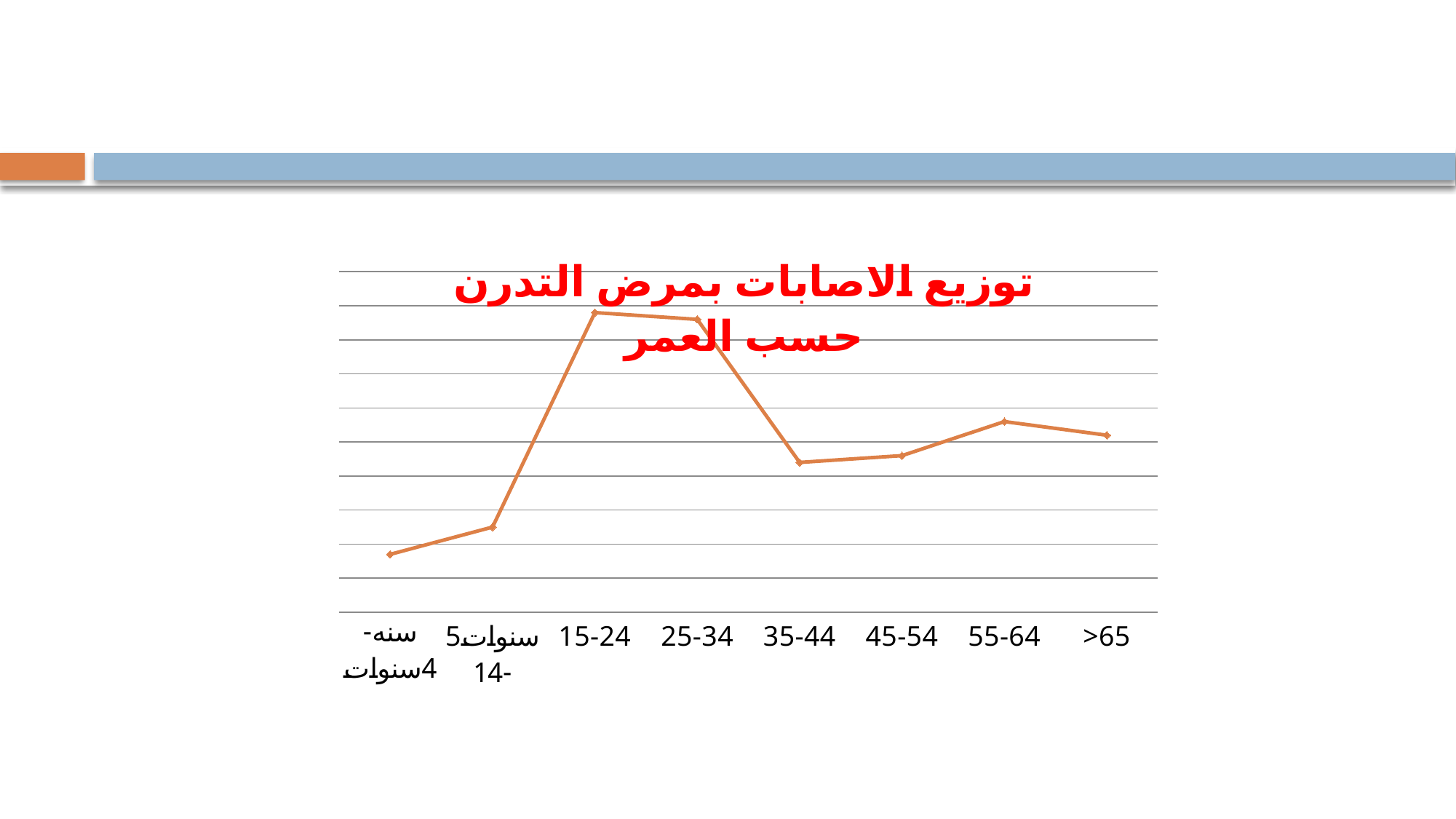
How many age categories are plotted along the x axis? 8 What kind of chart is shown on the slide? line chart How many data series (lines) are plotted on the chart? 1 Which has the larger value, 5سنوات-14 or 35-44? 35-44 Does the value rise or fall from سنه-4سنوات to 15-24? rise Which age category has the highest value on the chart? 15-24 What is the title of the chart? توزيع الاصابات بمرض التدرن حسب العمر Which has the larger value, 55-64 or >65? 55-64 Does the value rise or fall from 25-34 to 35-44? fall Which age category has the lowest value on the chart? سنه-4سنوات What colour is the line plotted on the chart? orange Which has the larger value, 35-44 or 55-64? 55-64